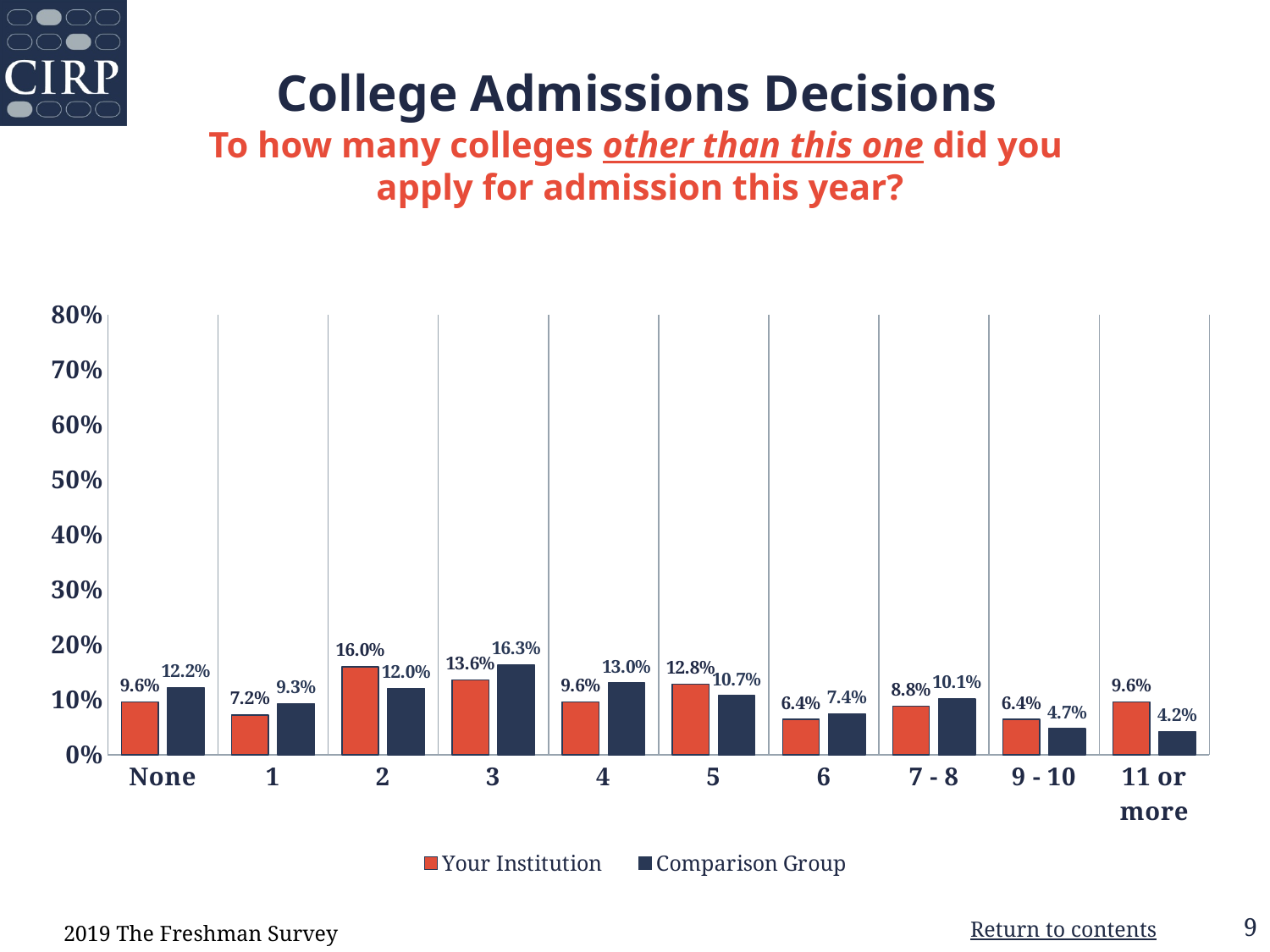
What is the value for Your Institution in the '2' category? 16.0% In the '4' category, which series has the larger value, Your Institution or Comparison Group? Comparison Group Which category has the lowest value for Comparison Group? 11 or more Which category has the highest value for Comparison Group? 3 How many categories are shown on the x axis? 10 What is the value for Comparison Group in the 'None' category? 12.2% Which category has the highest value for Your Institution? 2 How many series does the legend list? 2 What is the value for Comparison Group in the '11 or more' category? 4.2% What is the difference between Your Institution and Comparison Group in the '2' category? 4.0% What kind of chart is shown on the slide? Bar chart What is the difference between Your Institution and Comparison Group in the '11 or more' category? 5.4%